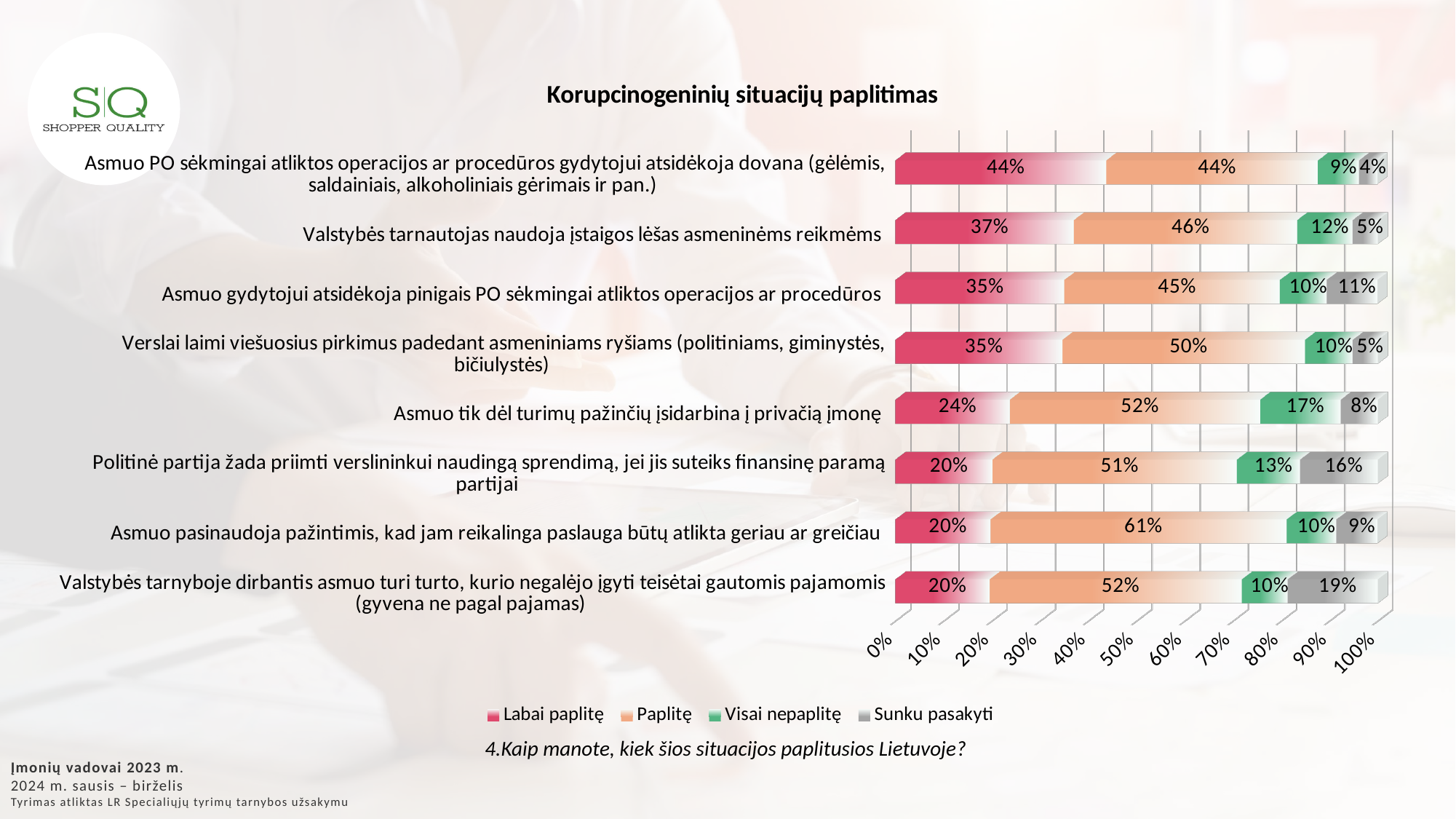
Which is larger: the 'Visai nepaplitę' value for 'Asmuo tik dėl turimų pažinčių įsidarbina į privačią įmonę' or for 'Politinė partija žada priimti verslininkui naudingą sprendimą, jei jis suteiks finansinę paramą partijai'? Asmuo tik dėl turimų pažinčių įsidarbina į privačią įmonę What is the total of the stacked bar for 'Valstybės tarnautojas naudoja įstaigos lėšas asmeninėms reikmėms'? 100% Which situation has the lowest 'Sunku pasakyti' value? Asmuo PO sėkmingai atliktos operacijos ar procedūros gydytojui atsidėkoja dovana (gėlėmis, saldainiais, alkoholiniais gėrimais ir pan.) What is the 'Paplitę' value for 'Asmuo pasinaudoja pažintimis, kad jam reikalinga paslauga būtų atlikta geriau ar greičiau'? 61% What is the 'Sunku pasakyti' value for 'Valstybės tarnyboje dirbantis asmuo turi turto, kurio negalėjo įgyti teisėtai gautomis pajamomis'? 19% What is the difference between the 'Paplitę' value for 'Asmuo pasinaudoja pažintimis, kad jam reikalinga paslauga būtų atlikta geriau ar greičiau' and the 'Paplitę' value for 'Valstybės tarnautojas naudoja įstaigos lėšas asmeninėms reikmėms'? 15% Which situation has the highest 'Labai paplitę' value? Asmuo PO sėkmingai atliktos operacijos ar procedūros gydytojui atsidėkoja dovana (gėlėmis, saldainiais, alkoholiniais gėrimais ir pan.) What is the 'Labai paplitę' value for 'Valstybės tarnautojas naudoja įstaigos lėšas asmeninėms reikmėms'? 37% What is the title of the chart? Korupcinogeninių situacijų paplitimas How many situations (categories) are listed in the chart? 8 How many series does the legend list? 4 What kind of chart is shown on the slide? Stacked bar chart